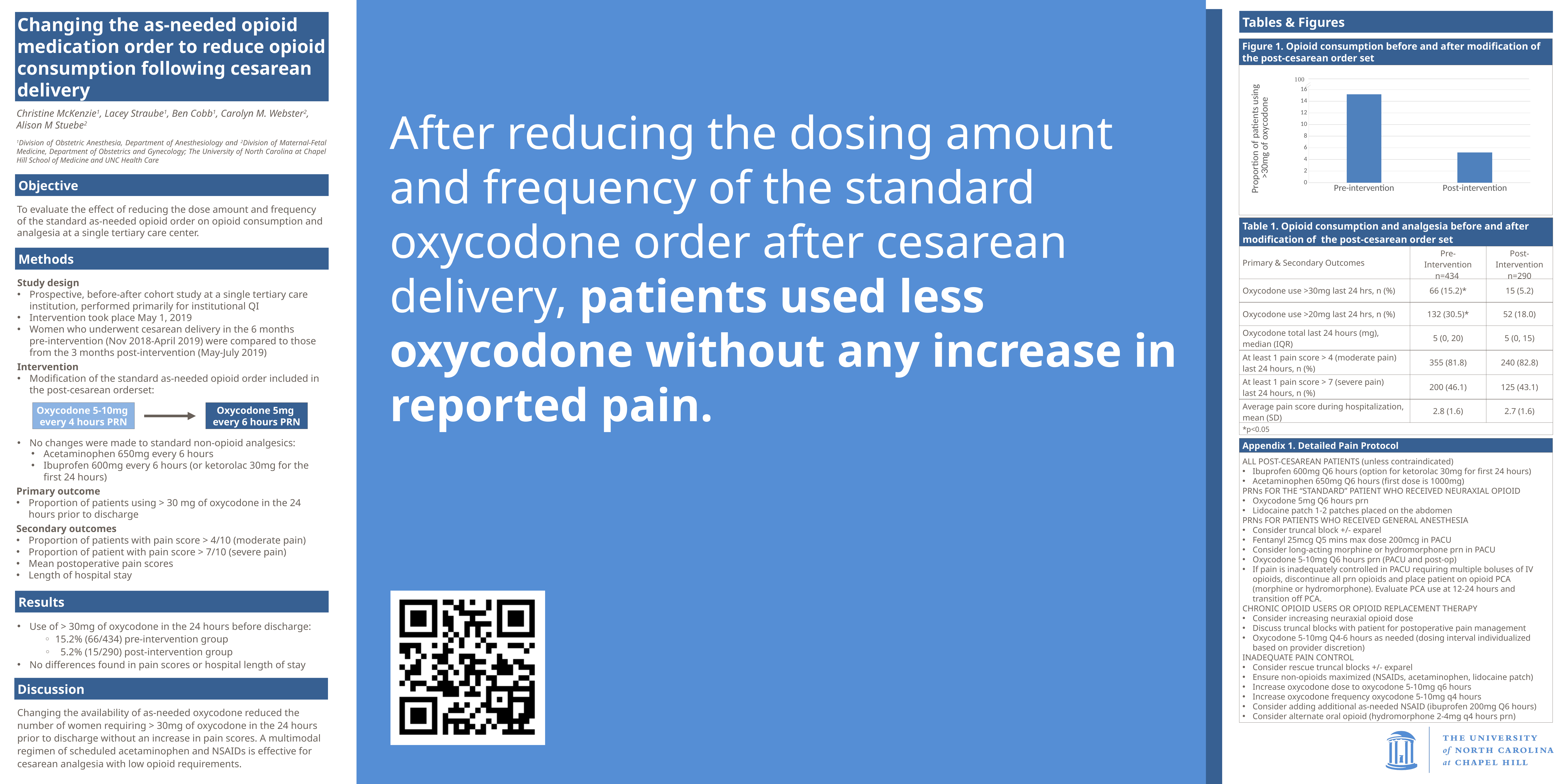
In Figure 1, how many categories are shown on the x axis? 2 In Figure 1, is the value for Post-intervention greater or less than 2? greater What is the title of Figure 1? Opioid consumption before and after modification of the post-cesarean order set In Figure 1, which category has the lowest proportion of patients using >30mg of oxycodone? Post-intervention In Figure 1, is the value for Post-intervention greater or less than 8? less In Figure 1, is the value for Pre-intervention larger or smaller than the value for Post-intervention? larger What is the y-axis label of Figure 1? Proportion of patients using >30mg of oxycodone In Figure 1, do the values rise or fall from Pre-intervention to Post-intervention? fall In Figure 1, which category has the highest proportion of patients using >30mg of oxycodone? Pre-intervention What kind of chart is Figure 1? bar chart In Figure 1, is the value for Pre-intervention greater or less than 10? greater